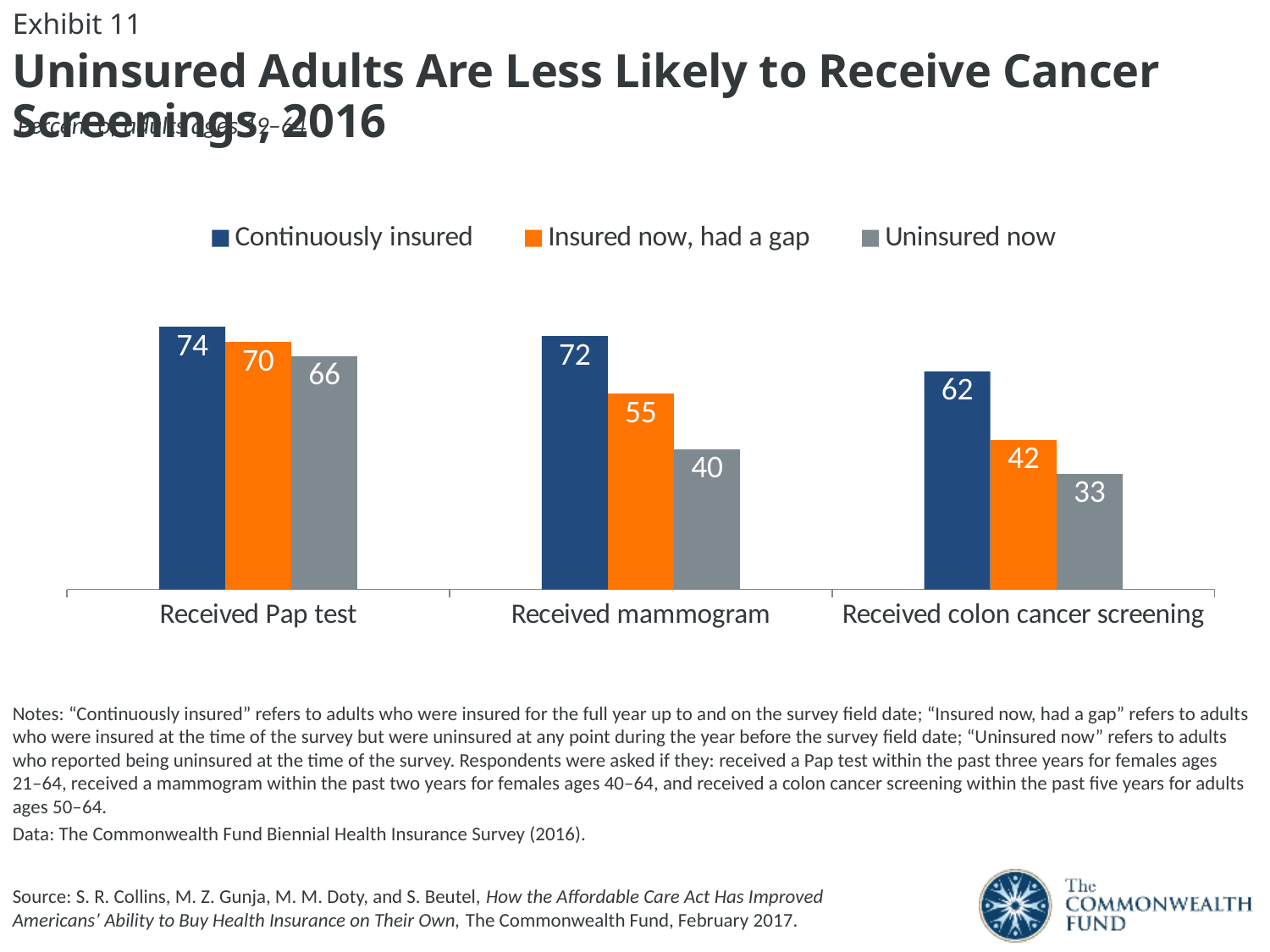
How many series does the legend list? 3 What is the difference between Continuously insured and Uninsured now for Received mammogram? 32 Which screening category has the lowest value for Uninsured now? Received colon cancer screening What is the value for Insured now, had a gap adults who received colon cancer screening? 42 Which screening category has the highest value for Continuously insured? Received Pap test Which colour represents the Uninsured now series? Gray What is the difference between Insured now, had a gap and Uninsured now for Received colon cancer screening? 9 What kind of chart is shown on the slide? Bar chart How many screening categories are shown on the x axis? 3 What is the value for Continuously insured adults who received a Pap test? 74 Which is larger: the Insured now, had a gap value for Received Pap test or for Received mammogram? Received Pap test What is the value for Uninsured now adults who received a mammogram? 40